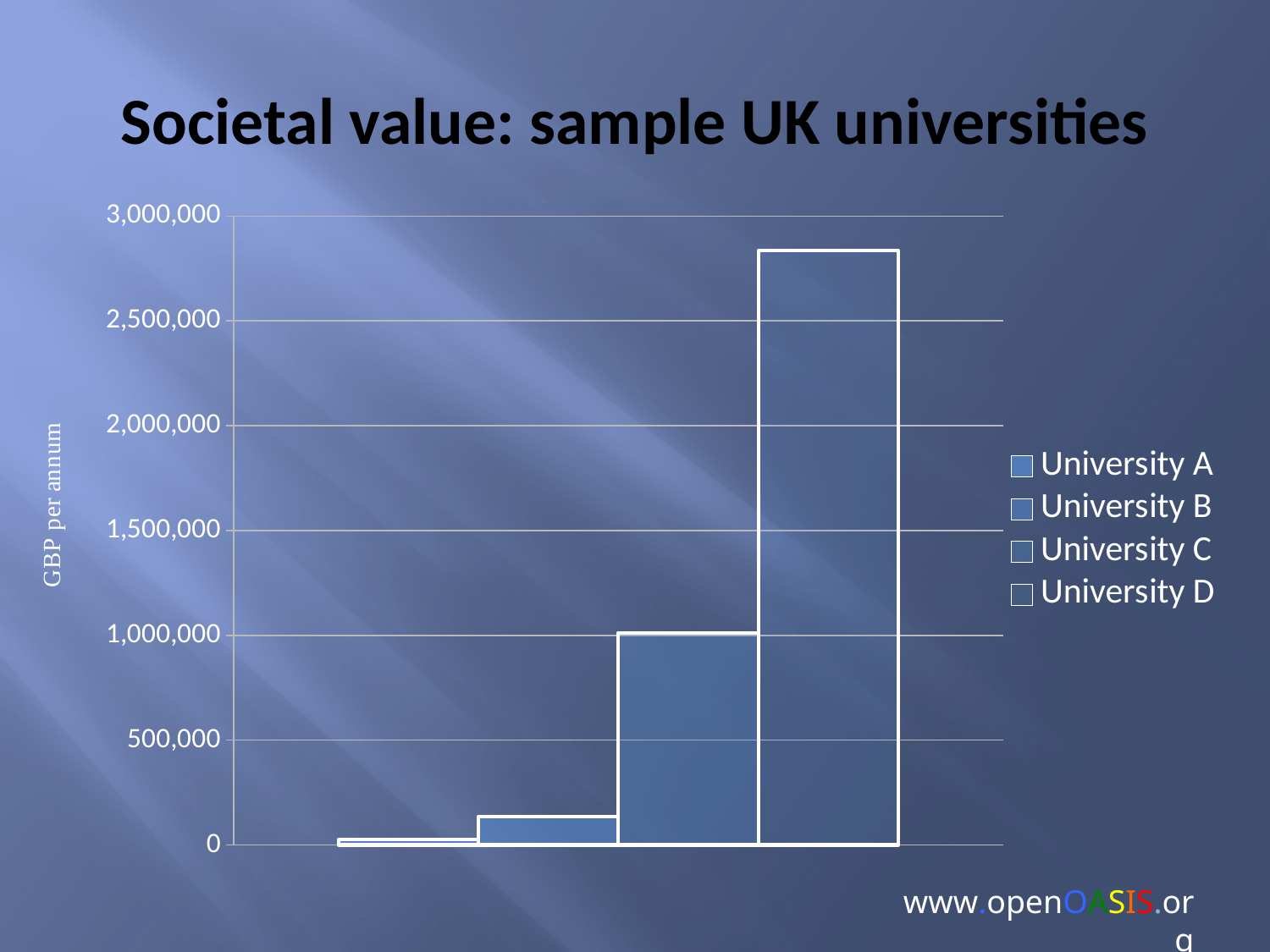
Which is larger, the value for University C or the value for University B? University C What is the title of the chart? Societal value: sample UK universities Is the value for University C greater or less than 500,000? greater Is the value for University D greater or less than 3,000,000? less How many series does the legend list? 4 Is the value for University D greater or less than 2,500,000? greater Which university has the lowest societal value? University A Which is larger, the value for University D or the value for University C? University D What kind of chart is shown on the slide? bar chart Which university has the highest societal value? University D What is the label on the vertical axis? GBP per annum